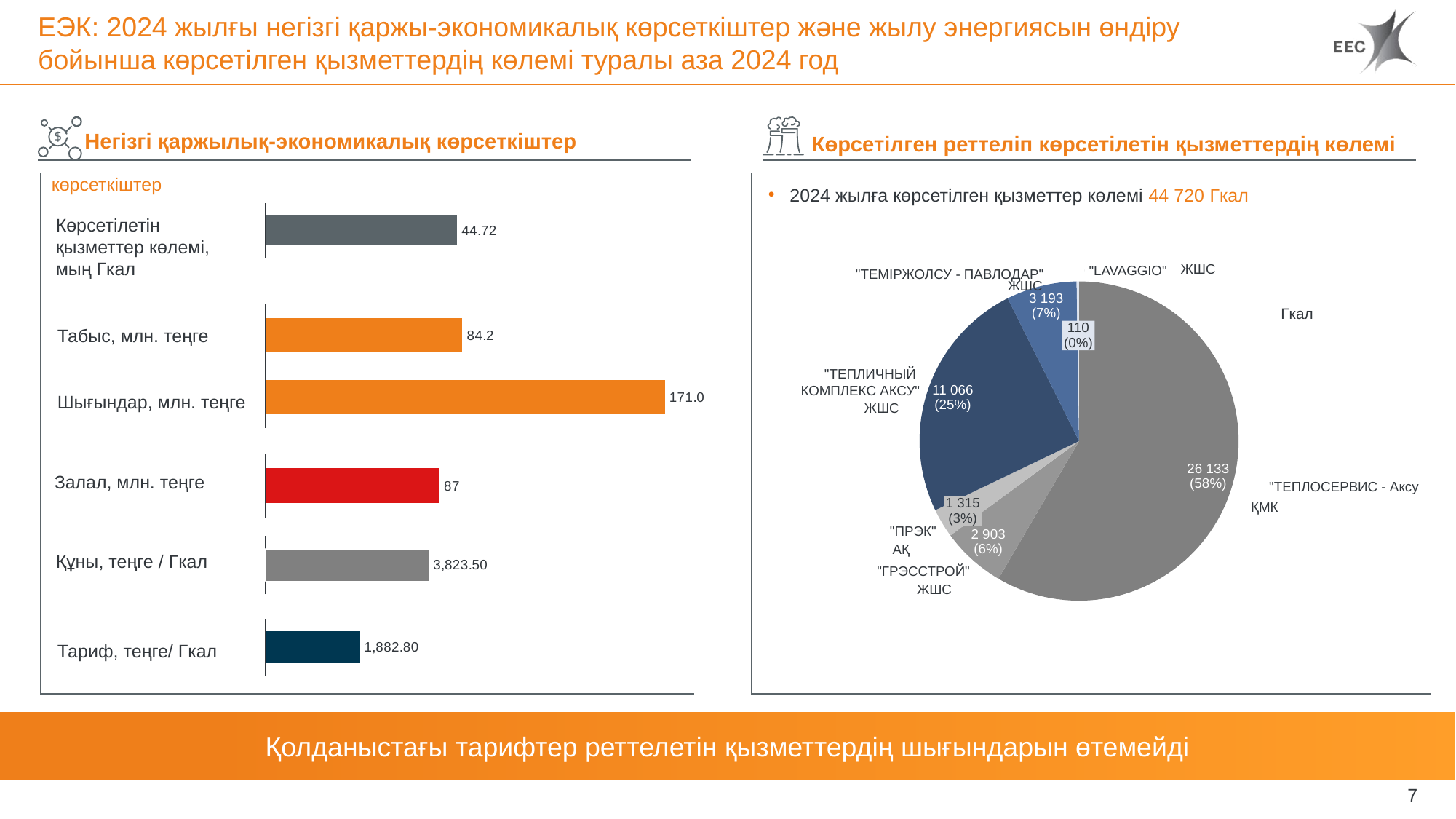
What kind of chart is the right chart? Pie chart On the right pie chart, which slice is the smallest? "LAVAGGIO" ЖШС On the left bar chart, what is the value for Табыс, млн. теңге? 84.2 On the right pie chart, what share does "ТЕПЛИЧНЫЙ КОМПЛЕКС АКСУ" ЖШС have? 25% On the right pie chart, how many slices are there? 6 On the right pie chart, what is the value for "ТЕПЛОСЕРВИС - Аксу" ҚМК? 26 133 (58%) On the left bar chart, which is larger: Құны, теңге / Гкал or Тариф, теңге/ Гкал? Құны, теңге / Гкал What kind of chart is the left chart? Bar chart On the left bar chart, what is the value for Шығындар, млн. теңге? 171.0 On the left bar chart, what is the difference between Шығындар, млн. теңге and Табыс, млн. теңге? 86.8 On the left bar chart, what is the value for Тариф, теңге/ Гкал? 1,882.80 On the left bar chart, how many categories are shown? 6